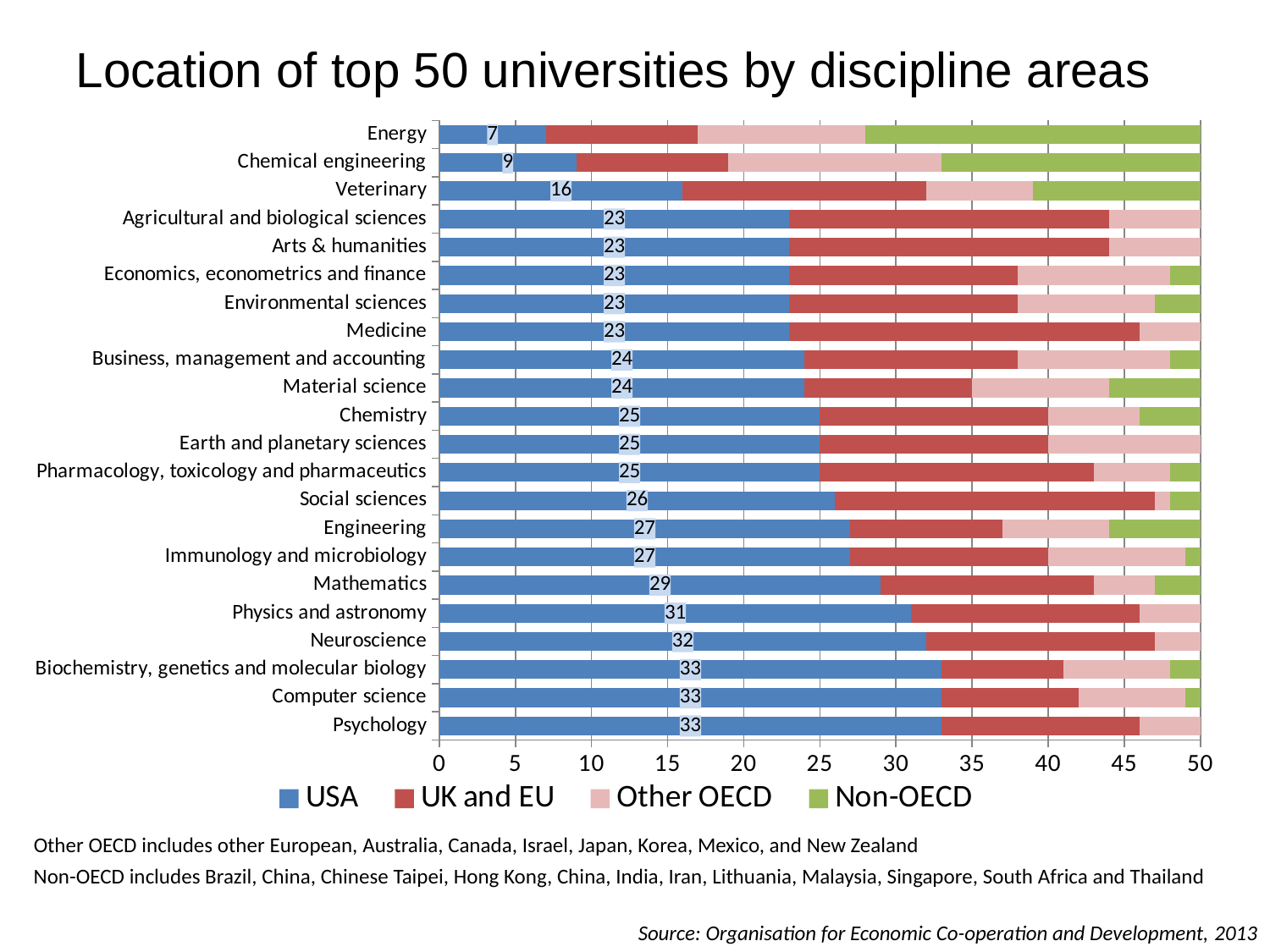
What is the USA value for Veterinary? 16 Is the USA value for Chemical engineering greater or less than 10? less What is the difference between the USA values for Neuroscience and Veterinary? 16 What is the USA value for Mathematics? 29 Which discipline area has the lowest USA value? Energy What is the USA value for Energy? 7 What is the USA value for Psychology? 33 What is the difference between the USA values for Psychology and Energy? 26 How many discipline areas are shown on the chart? 22 What kind of chart is shown on the slide? Stacked bar chart Which has a larger USA value, Mathematics or Chemistry? Mathematics How many series does the legend list? 4